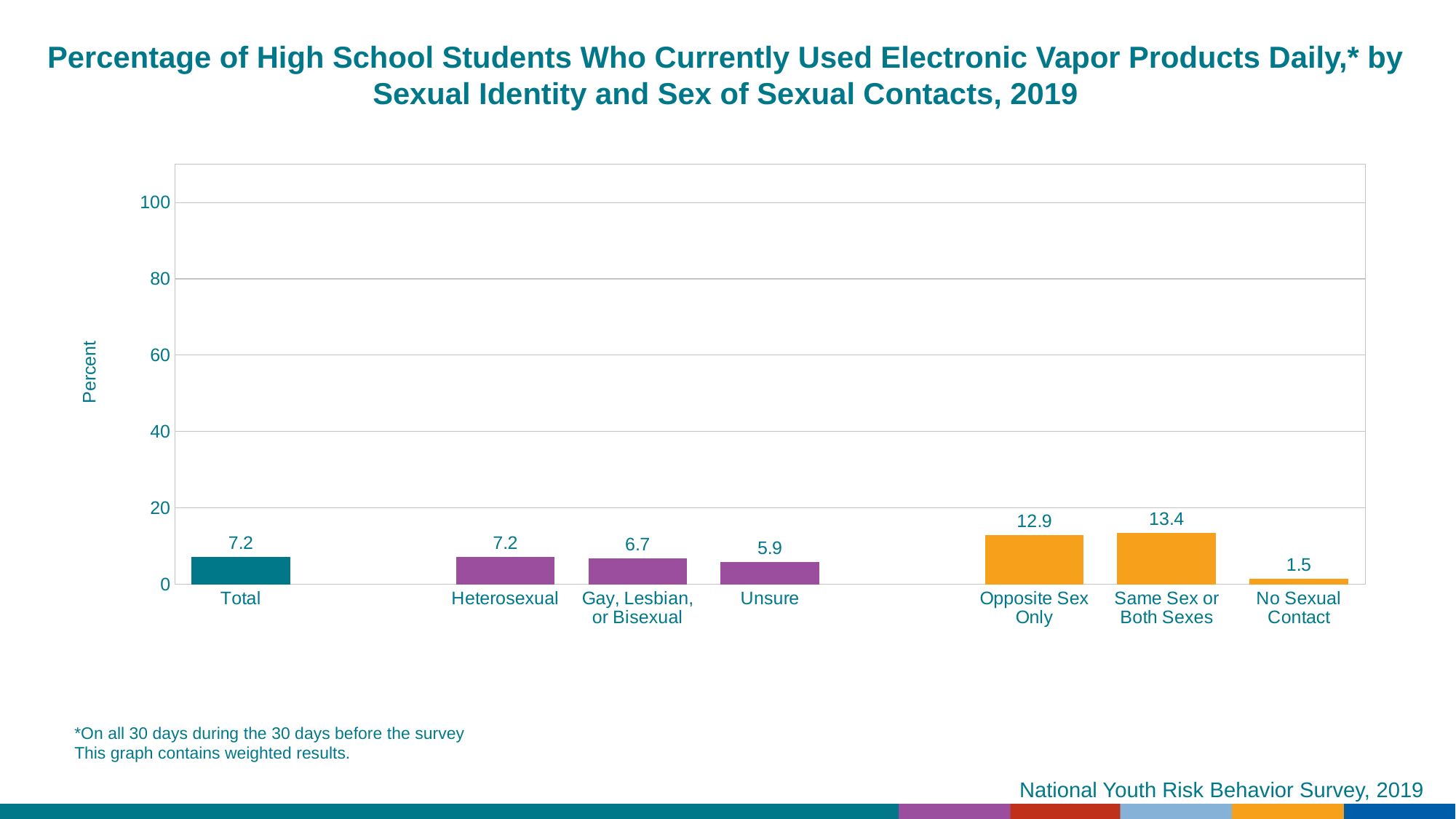
What is the label of the y axis? Percent What is the value for Total? 7.2 How many categories are shown on the x axis? 7 What is the value for No Sexual Contact? 1.5 Is the value for Opposite Sex Only greater or less than 20? less Which category has the lowest value? No Sexual Contact What is the value for Same Sex or Both Sexes? 13.4 What kind of chart is this? bar chart What is the value for Gay, Lesbian, or Bisexual students? 6.7 Which is larger, the value for Heterosexual or the value for Unsure? Heterosexual What is the difference between the values for Opposite Sex Only and No Sexual Contact? 11.4 Which category has the highest value? Same Sex or Both Sexes